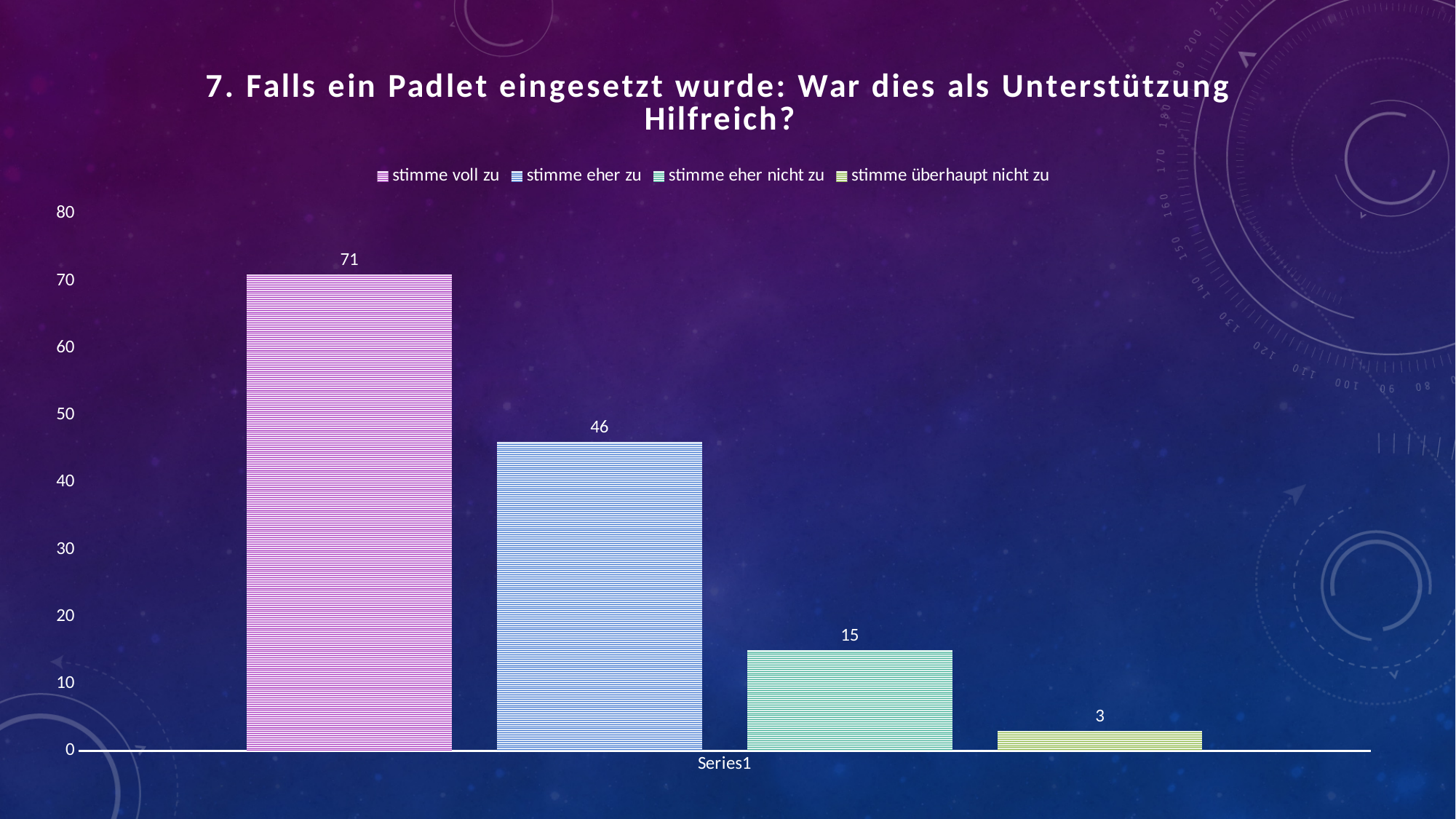
How many series does the legend list? 4 What is the value for "stimme eher nicht zu"? 15 What kind of chart is shown on the slide? bar chart What is the difference between the values for "stimme voll zu" and "stimme eher zu"? 25 Which is larger, the value for "stimme eher nicht zu" or the value for "stimme überhaupt nicht zu"? stimme eher nicht zu Do the bar values rise or fall from left to right? fall What is the value for "stimme voll zu"? 71 Which response option has the highest value? stimme voll zu What is the title of the chart? 7. Falls ein Padlet eingesetzt wurde: War dies als Unterstützung Hilfreich? What is the value for "stimme eher zu"? 46 What is the value for "stimme überhaupt nicht zu"? 3 Which response option has the lowest value? stimme überhaupt nicht zu